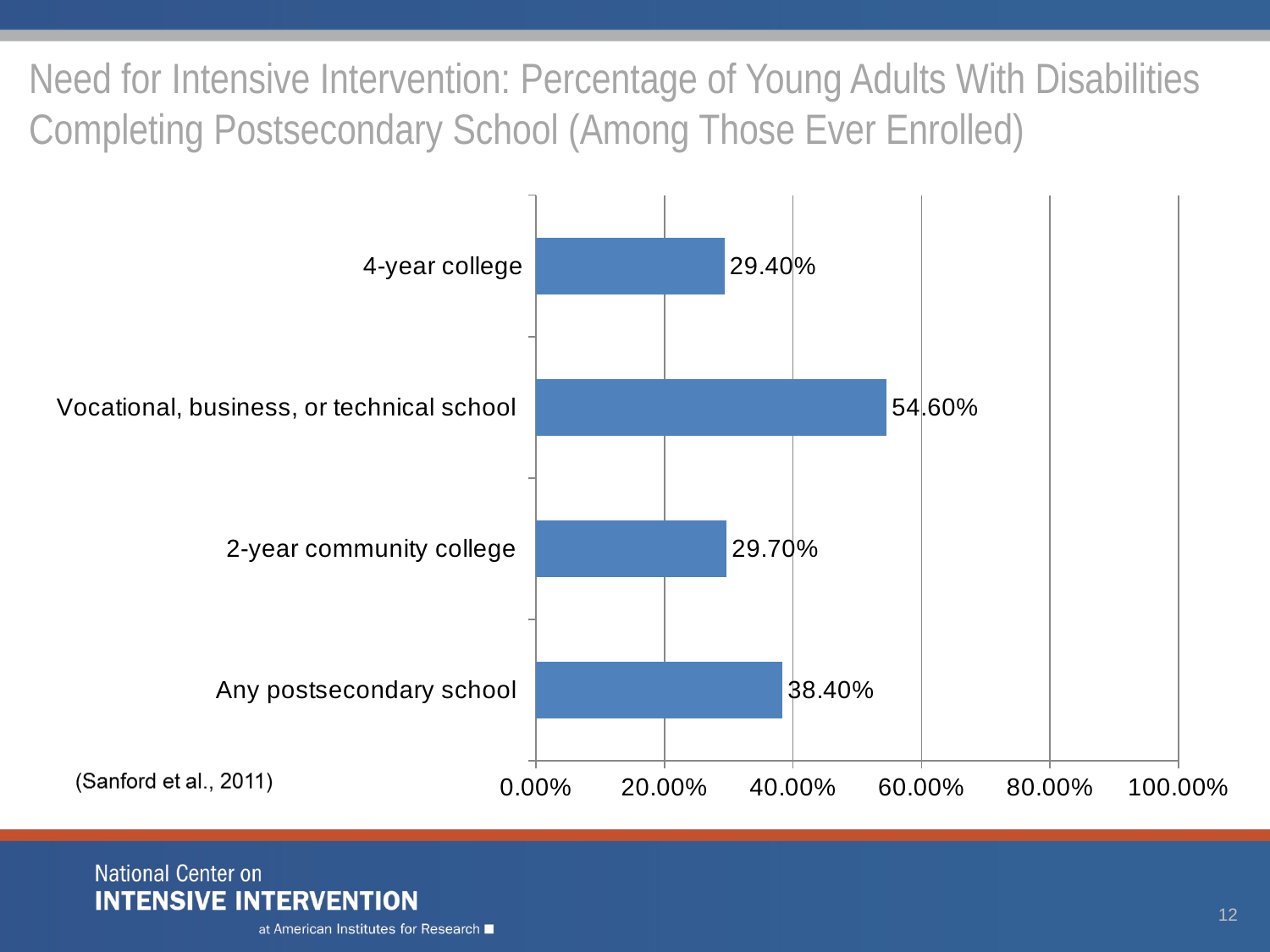
Which is larger, the value for Any postsecondary school or the value for 4-year college? Any postsecondary school Which category has the highest completion percentage? Vocational, business, or technical school What type of chart is shown on the slide? Bar chart Is the value for Vocational, business, or technical school greater or less than 40.00%? greater What percentage of young adults with disabilities completed a 4-year college? 29.40% What is the value shown for 2-year community college? 29.70% How many percentage points higher is Vocational, business, or technical school than Any postsecondary school? 16.20 percentage points What percentage is shown for Any postsecondary school? 38.40% Which category has the lowest completion percentage? 4-year college How many categories are shown in the chart? 4 What is the value shown for Vocational, business, or technical school? 54.60% What is the difference between the values for Any postsecondary school and 2-year community college? 8.70 percentage points